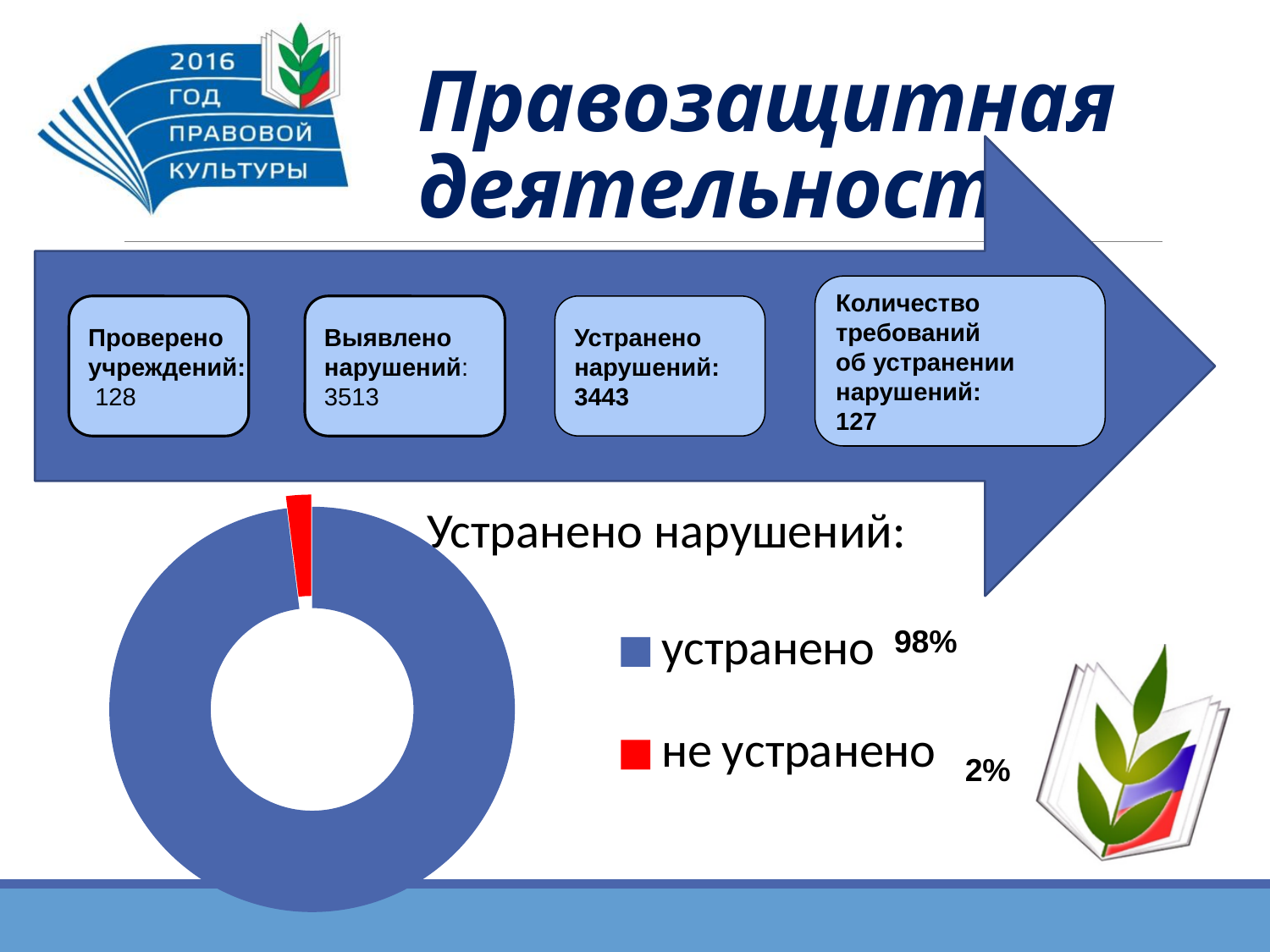
How many categories does the chart show? 2 How many entries does the chart legend list? 2 What is the title of the chart on the slide? Устранено нарушений: What kind of chart is shown on the slide? doughnut chart What share of the chart is labelled "не устранено"? 2% What is the difference in percentage points between the "устранено" and "не устранено" shares? 96 What share of the chart is labelled "устранено"? 98% Which is larger, the share for "устранено" or the share for "не устранено"? устранено What colour represents "не устранено" in the chart? red Which category has the smallest share in the chart? не устранено Which category has the largest share in the chart? устранено